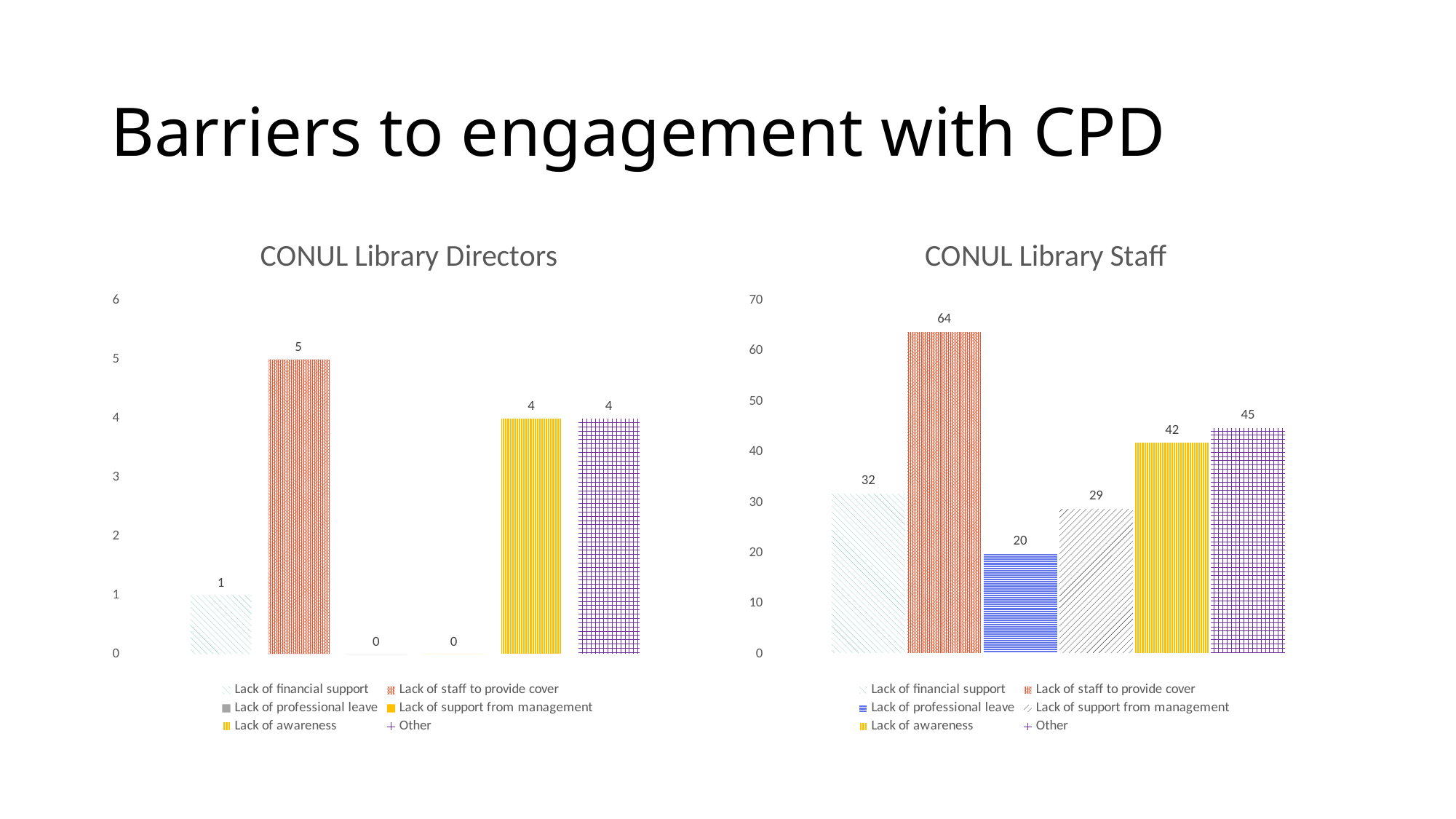
In the CONUL Library Staff chart, is the value for Lack of awareness greater or less than 40? greater What kind of chart is the CONUL Library Staff chart? bar chart In the CONUL Library Staff chart, which is larger: Lack of financial support or Other? Other In the CONUL Library Directors chart, what is the difference between Lack of staff to provide cover and Lack of financial support? 4 In the CONUL Library Staff chart, what is the value for Lack of support from management? 29 In the CONUL Library Directors chart, which category has the highest value? Lack of staff to provide cover In the CONUL Library Staff chart, which category has the lowest value? Lack of professional leave In the CONUL Library Directors chart, how many categories have a value of 0? 2 How many series does the legend of the CONUL Library Directors chart list? 6 In the CONUL Library Directors chart, what is the value for Lack of staff to provide cover? 5 In the CONUL Library Staff chart, what is the difference between Lack of staff to provide cover and Lack of awareness? 22 In the CONUL Library Staff chart, which category has the highest value? Lack of staff to provide cover